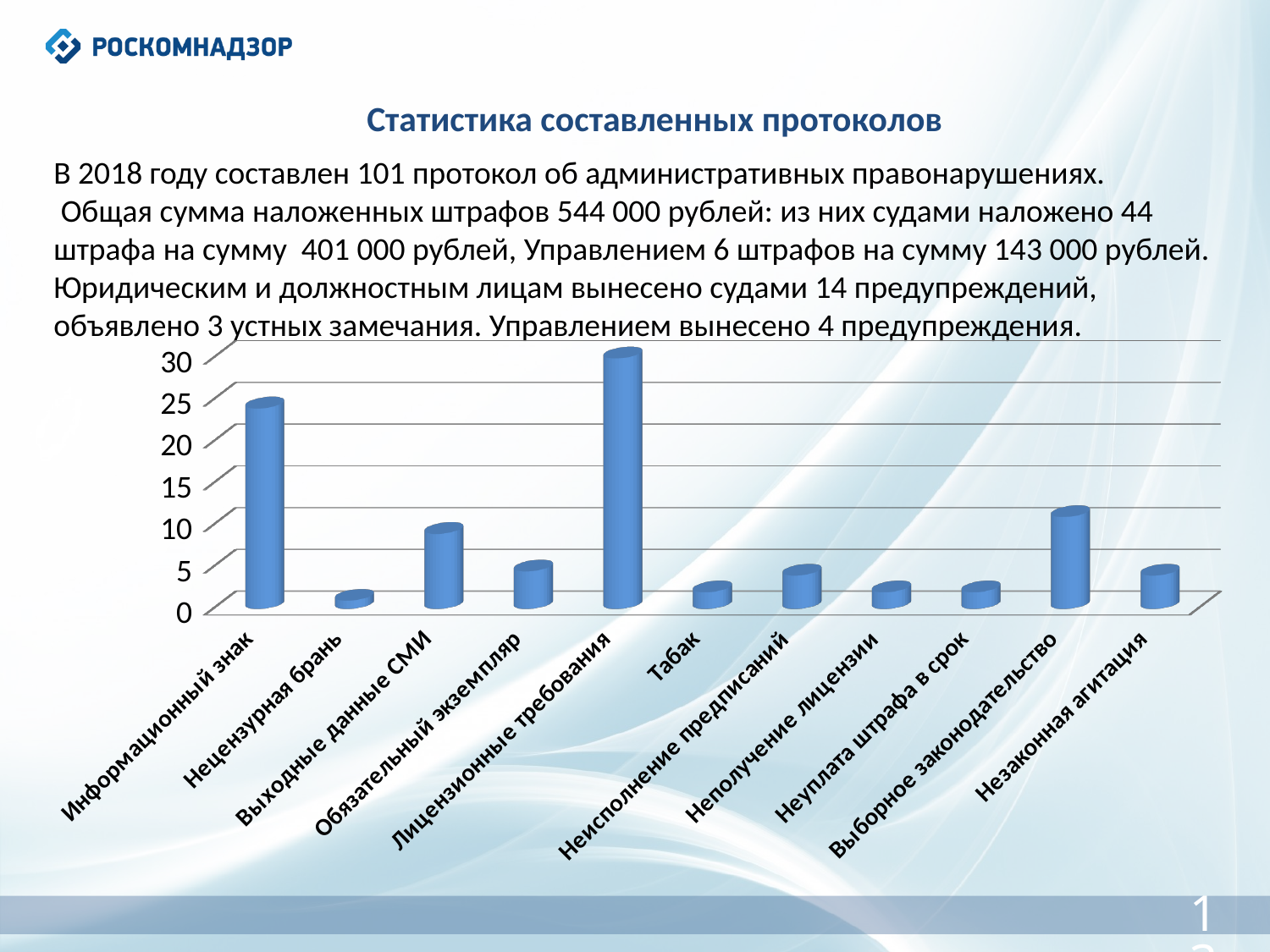
Which is larger, the value for Информационный знак or the value for Выборное законодательство? Информационный знак Which is larger, the value for Выходные данные СМИ or the value for Нецензурная брань? Выходные данные СМИ Is the value for Лицензионные требования greater or less than 25? greater Is the value for Выходные данные СМИ greater or less than 5? greater What is the highest tick value shown on the vertical axis of the chart? 30 Is the value for Табак greater or less than 5? less Which category has the highest bar on the chart? Лицензионные требования What is the title of the slide containing the chart? Статистика составленных протоколов How many categories are plotted on the chart? 11 What kind of chart is shown on the slide? bar chart